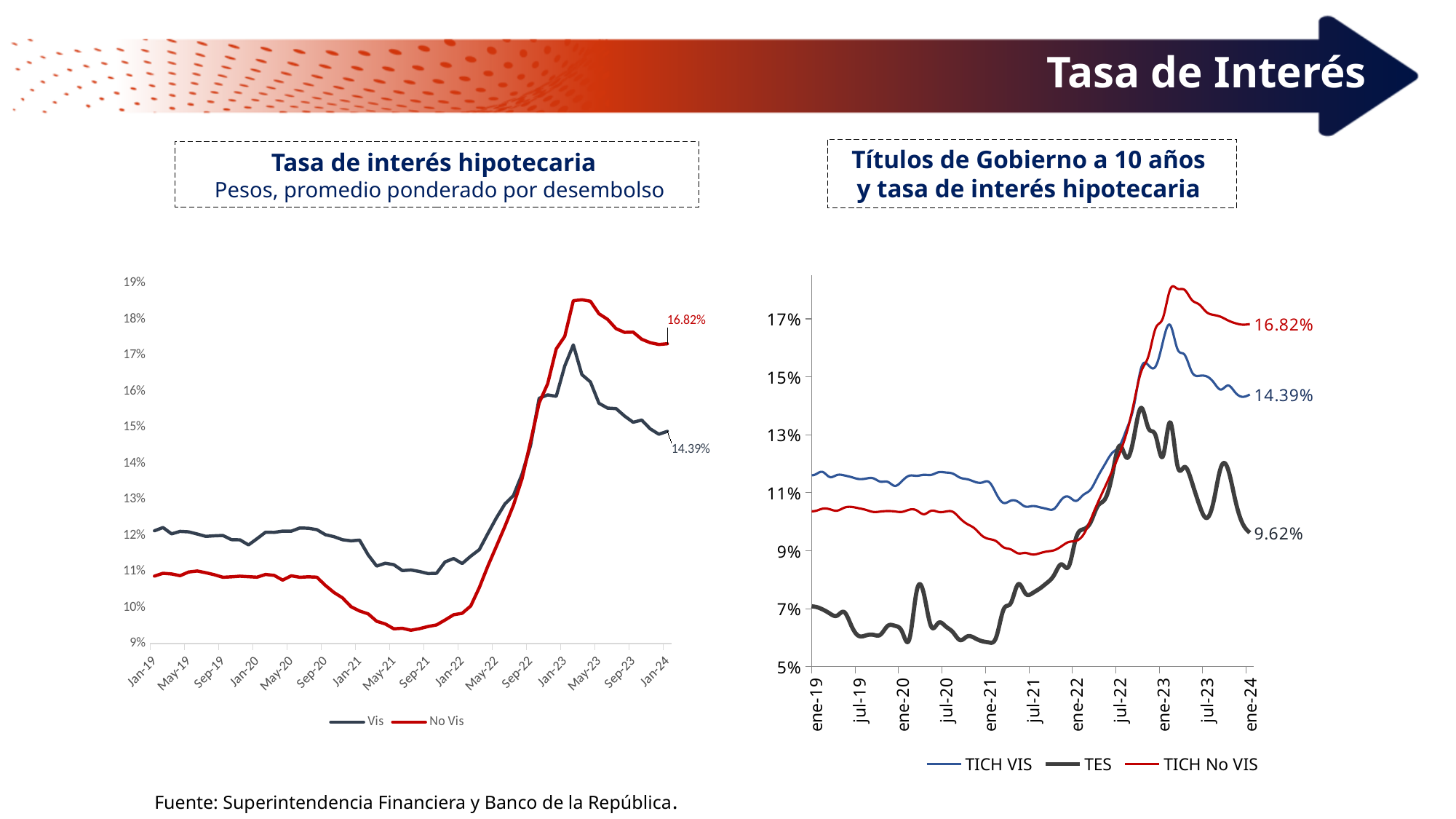
In the right chart 'Títulos de Gobierno a 10 años y tasa de interés hipotecaria', what is the difference between the final labelled values of TICH VIS and TES? 4.77% How many series does the legend of the right chart 'Títulos de Gobierno a 10 años y tasa de interés hipotecaria' list? 3 In the left chart 'Tasa de interés hipotecaria', does the No Vis series rise or fall between Sep-21 and Jan-23? Rise In the right chart 'Títulos de Gobierno a 10 años y tasa de interés hipotecaria', what is the final labelled value of the TES series? 9.62% What kind of chart is the left chart 'Tasa de interés hipotecaria'? Line chart In the left chart 'Tasa de interés hipotecaria', what is the final labelled value of the No Vis series? 16.82% In the right chart 'Títulos de Gobierno a 10 años y tasa de interés hipotecaria', is the TES value at ene-21 greater or less than 7%? less In the left chart 'Tasa de interés hipotecaria', which series ends higher at Jan-24, Vis or No Vis? No Vis In the right chart 'Títulos de Gobierno a 10 años y tasa de interés hipotecaria', what is the final labelled value of the TICH No VIS series? 16.82% In the left chart 'Tasa de interés hipotecaria', what is the difference between the final labelled values of No Vis and Vis? 2.43% In the left chart 'Tasa de interés hipotecaria', what is the final labelled value of the Vis series? 14.39% In the right chart 'Títulos de Gobierno a 10 años y tasa de interés hipotecaria', which series has the lowest final labelled value? TES